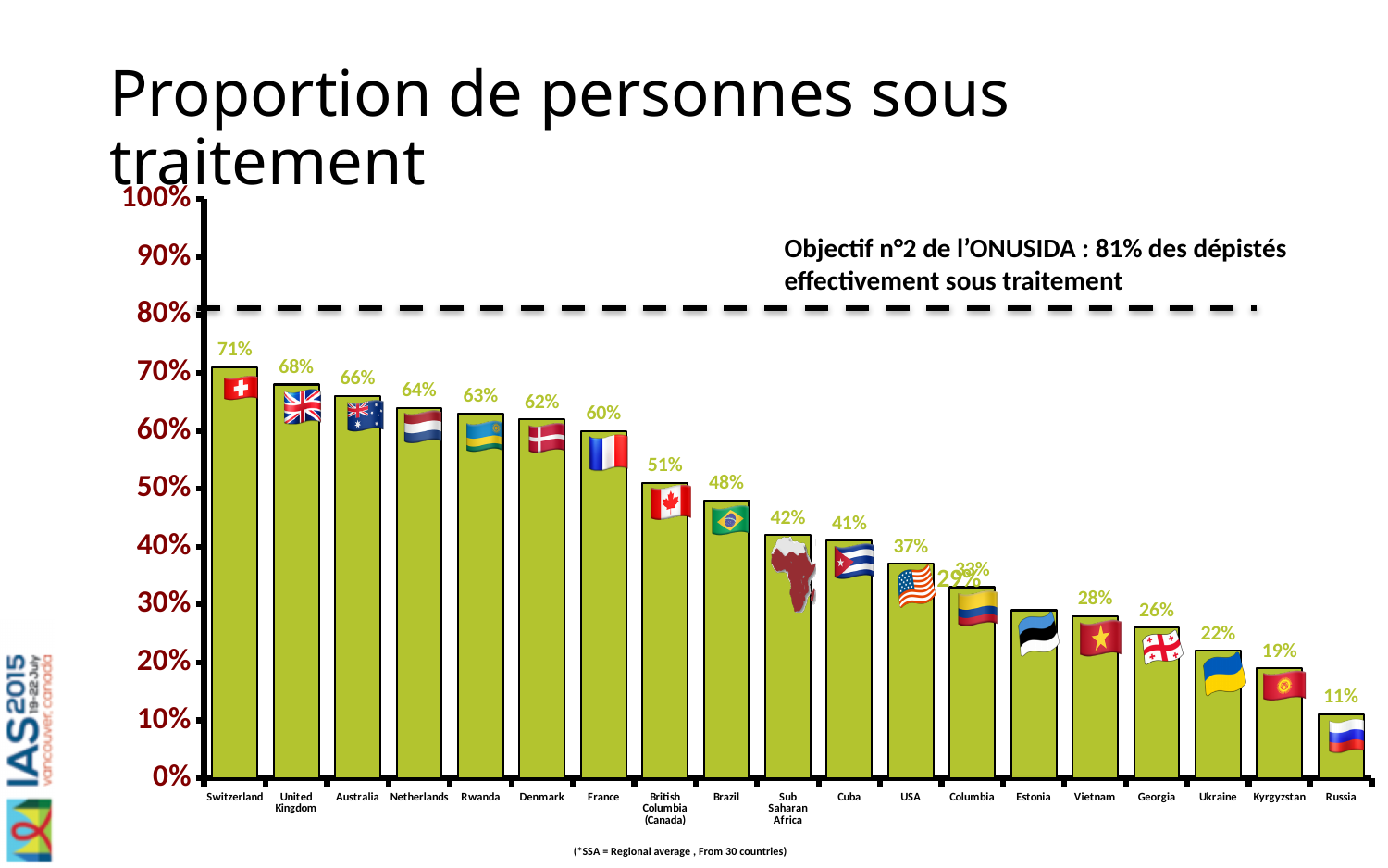
Which country has the lowest proportion of people under treatment? Russia What kind of chart is shown on the slide? Bar chart Which has a higher value, Brazil or Cuba? Brazil Is the value for USA greater or less than 40%? less What is the value for Russia? 11% Do the values rise or fall from left to right along the x axis? Fall What is the value for Switzerland? 71% Which country has the highest proportion of people under treatment? Switzerland How many countries or regions are shown on the chart? 19 What is the difference between the values for Switzerland and Russia? 60 percentage points What is the value for France? 60% What is the value for Vietnam? 28%